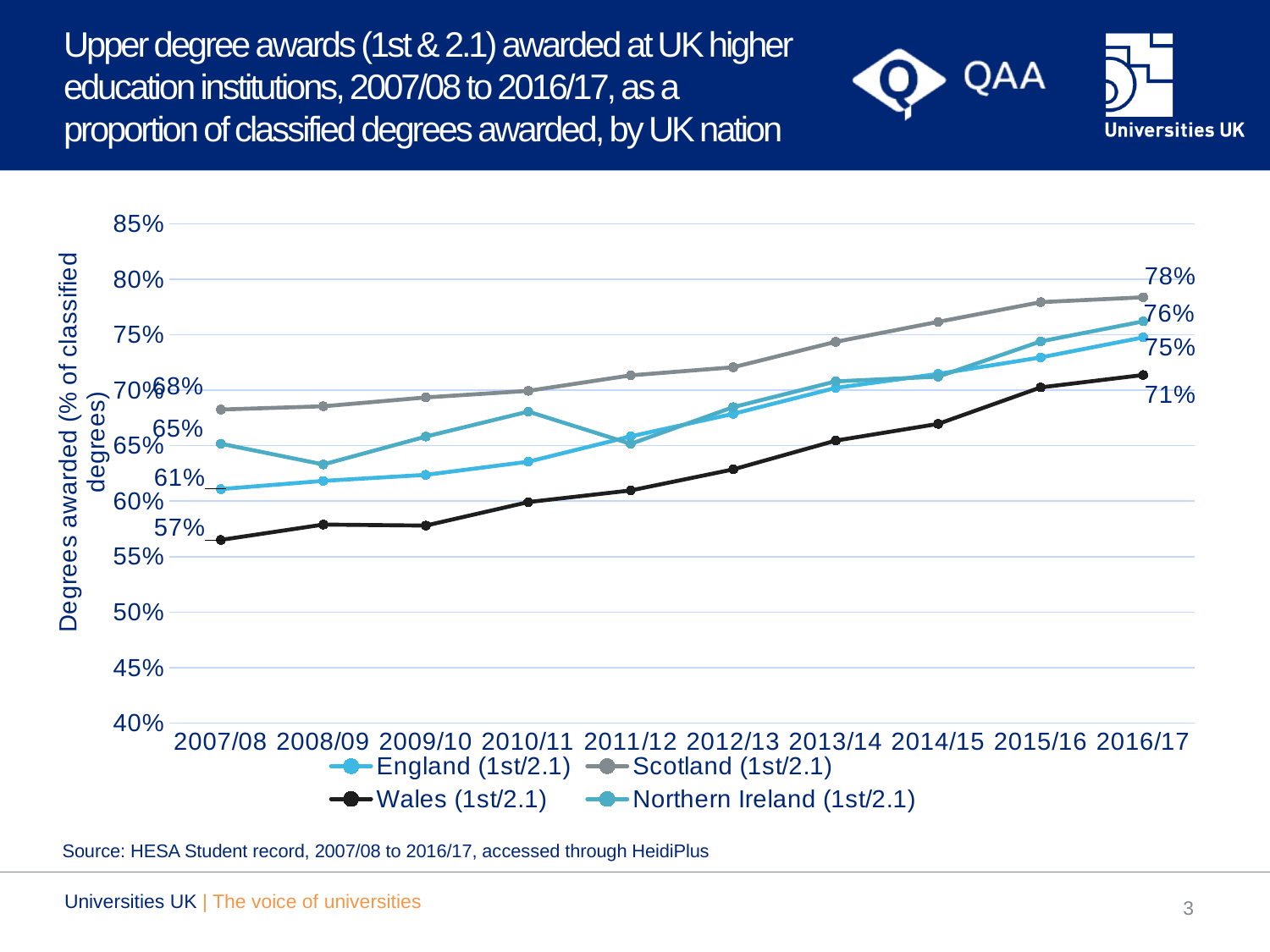
By how many percentage points did the Scotland (1st/2.1) value increase from 2007/08 to 2016/17? 10 percentage points What was the value for Northern Ireland (1st/2.1) in 2016/17? 76% Is the value for Wales (1st/2.1) in 2011/12 greater or less than 65%? less What kind of chart is shown on the slide? Line chart Which nation had the highest proportion of upper degree awards in 2016/17? Scotland What proportion of upper degree awards did Scotland (1st/2.1) have in 2016/17? 78% Which nation had the lowest proportion of upper degree awards in 2007/08? Wales How many academic years are shown along the x axis? 10 What was the value for Wales (1st/2.1) in 2007/08? 57% Does the Wales (1st/2.1) line rise or fall from 2007/08 to 2016/17? Rise How many series does the legend list? 4 What was the value for England (1st/2.1) in 2007/08? 61%